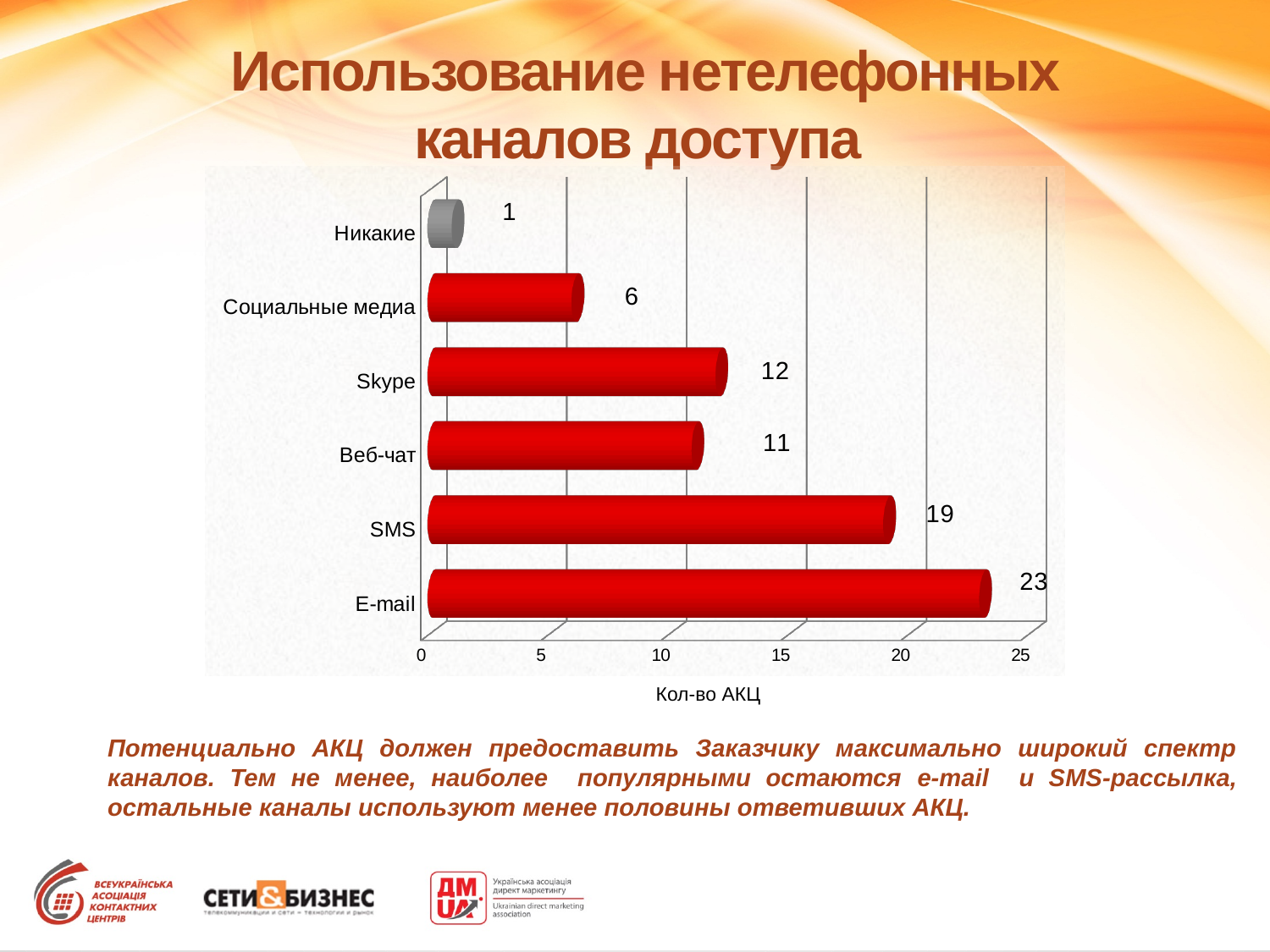
What is the difference between the values for E-mail and SMS? 4 Which is larger, the value for Skype or the value for Веб-чат? Skype Is the value for SMS greater or less than 15? greater What is the value for SMS? 19 What is the value for Социальные медиа? 6 What is the label of the horizontal axis? Кол-во АКЦ Which category has the highest value? E-mail Which category has the lowest value? Никакие How many categories are shown in the chart? 6 What is the value for Skype? 12 What is the value for E-mail? 23 What kind of chart is shown on the slide? bar chart